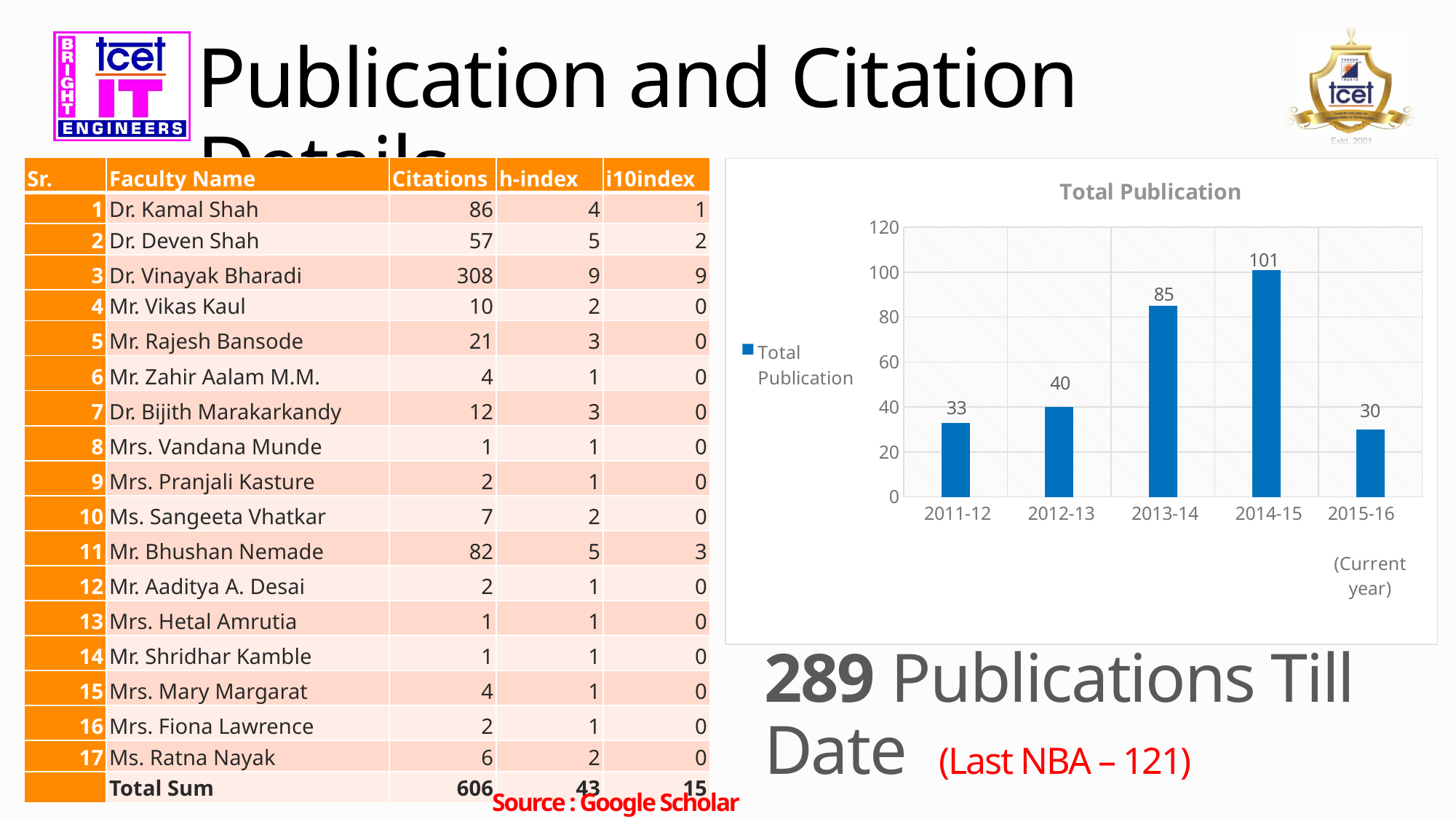
Which is larger in the Total Publication chart, the value for 2012-13 or 2015-16? 2012-13 What is the value for 2015-16 in the Total Publication chart? 30 What is the value for 2013-14 in the Total Publication chart? 85 Which year has the lowest value in the Total Publication chart? 2015-16 What kind of chart is the Total Publication chart? bar chart Which year has the highest value in the Total Publication chart? 2014-15 What is the difference between the values for 2012-13 and 2011-12 in the Total Publication chart? 7 How many years are shown on the x axis of the Total Publication chart? 5 How many series does the legend of the Total Publication chart list? 1 Is the value for 2014-15 in the Total Publication chart greater or less than 80? greater What is the difference between the values for 2014-15 and 2013-14 in the Total Publication chart? 16 What is the value for 2011-12 in the Total Publication chart? 33